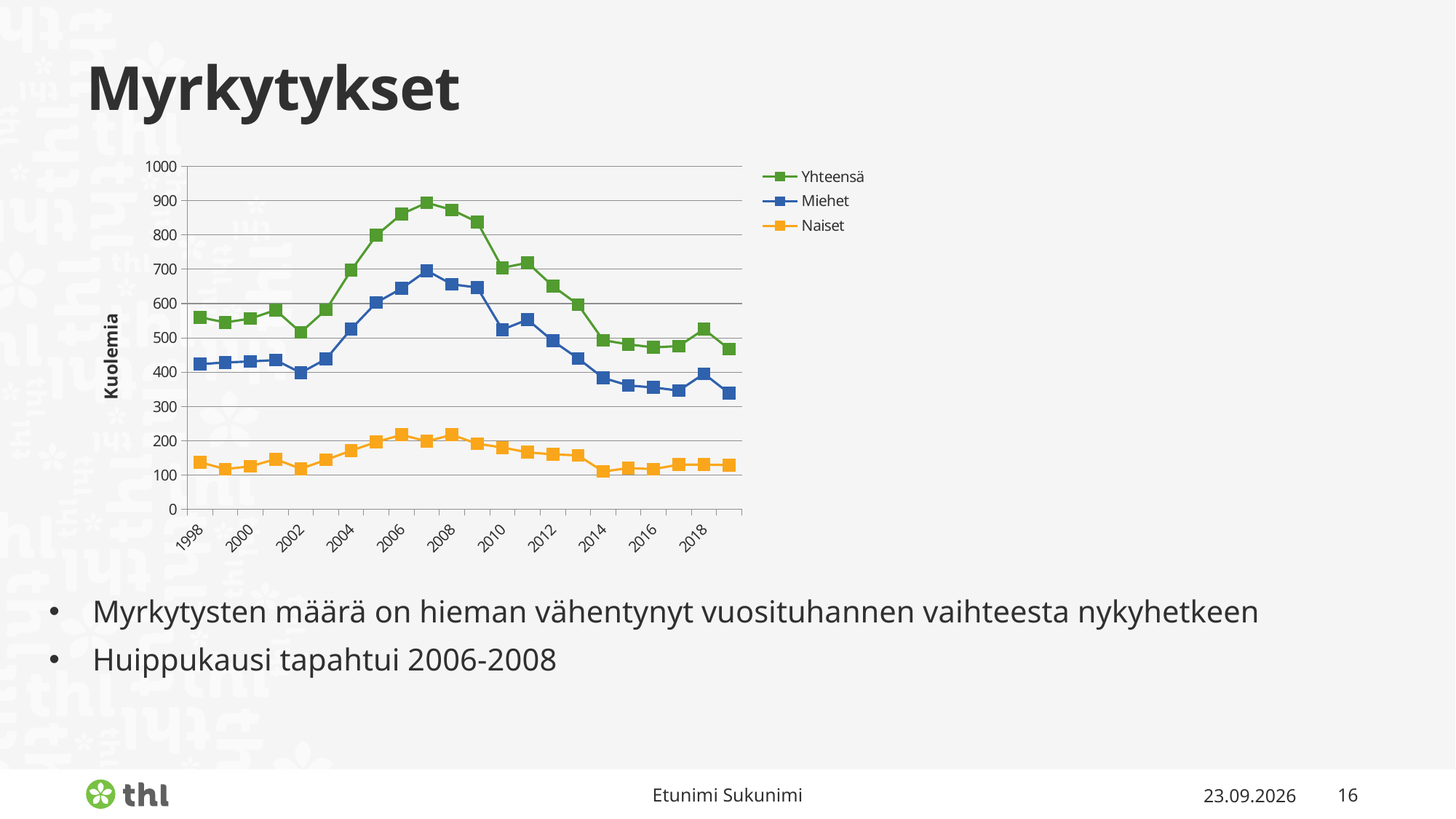
What are the three series named in the legend? Yhteensä, Miehet, Naiset In which year does the Yhteensä series reach its highest value? 2007 Is the Naiset value for 2014 greater or less than 150? less Is the Miehet value for 2019 greater or less than 400? less What kind of chart is shown on the slide? line chart Does the Yhteensä series rise or fall between 2007 and 2014? fall How many series does the chart legend list? 3 How many yearly data points does each series have? 22 Is the Yhteensä value for 2007 greater or less than 800? greater What is the label on the vertical axis of the chart? Kuolemia In which year does the Miehet series reach its highest value? 2007 Which is larger in 2010, the Miehet value or the Naiset value? Miehet